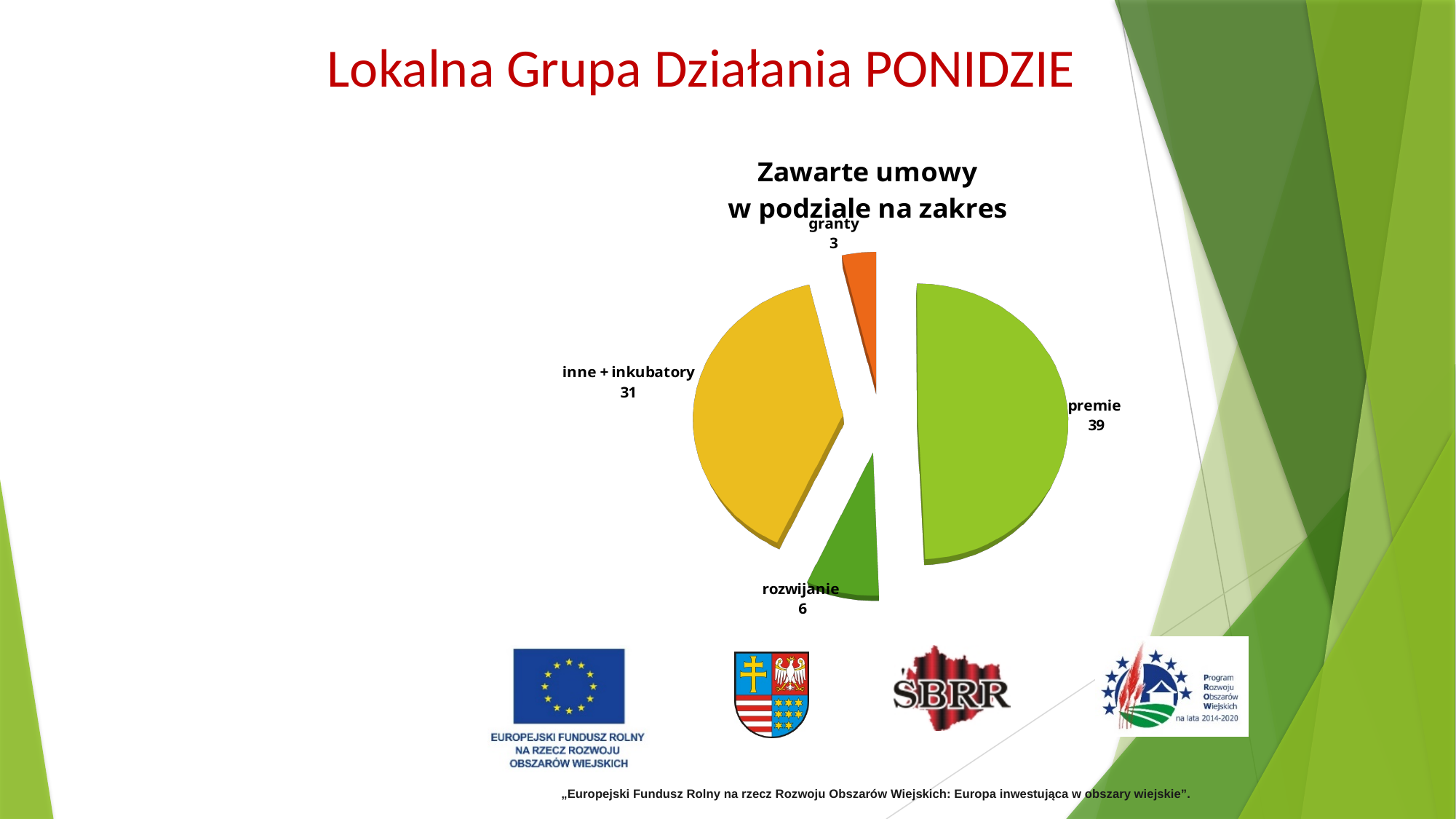
What is the value for premie? 39 What type of chart is shown on the slide? pie chart What is the value for rozwijanie? 6 What is the title of the chart? Zawarte umowy w podziale na zakres Which category has the smallest slice? granty Which category has the largest slice? premie What is the value for inne + inkubatory? 31 What is the total of all slices in the pie chart? 79 How many slices does the pie chart have? 4 What is the difference between the values for premie and inne + inkubatory? 8 What is the value for granty? 3 Which is larger, rozwijanie or granty? rozwijanie